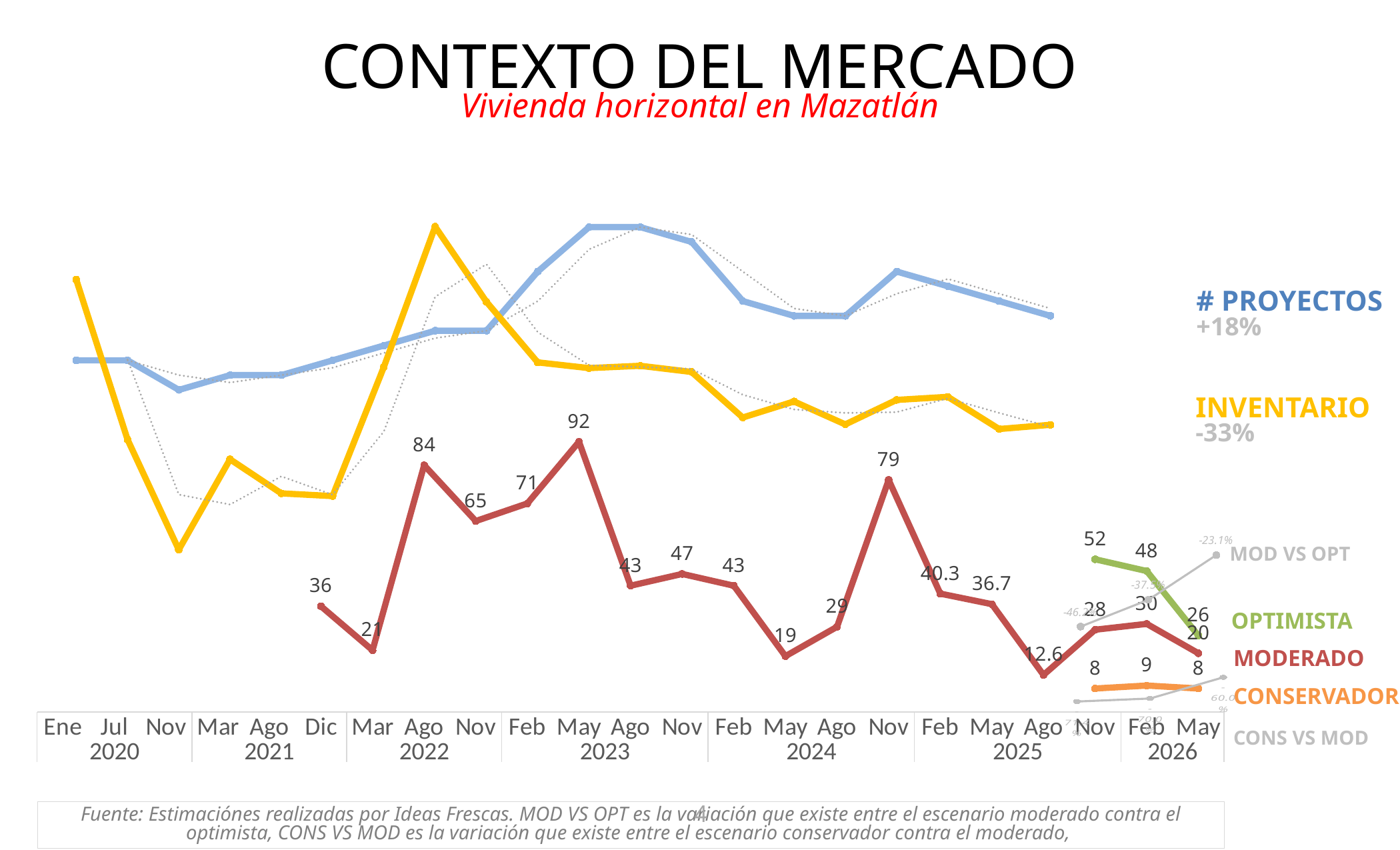
What is the CONSERVADOR value for Feb 2026? 9 What is the difference between the MODERADO values for May 2023 and Ago 2023? 49 In Nov 2025, how much higher is the OPTIMISTA value than the MODERADO value? 24 What kind of chart is shown on the slide? line chart Which is larger for the MODERADO series: the value for Ago 2022 or the value for Nov 2022? Ago 2022 What is the OPTIMISTA value for May 2026? 26 What is the highest labelled value of the MODERADO series? 92 What is the MODERADO value for Nov 2024? 79 What is the lowest labelled value of the MODERADO series? 12.6 Does the OPTIMISTA series rise or fall from Nov 2025 to May 2026? fall What percentage change is shown next to the # PROYECTOS label? +18% What percentage change is shown next to the INVENTARIO label? -33%